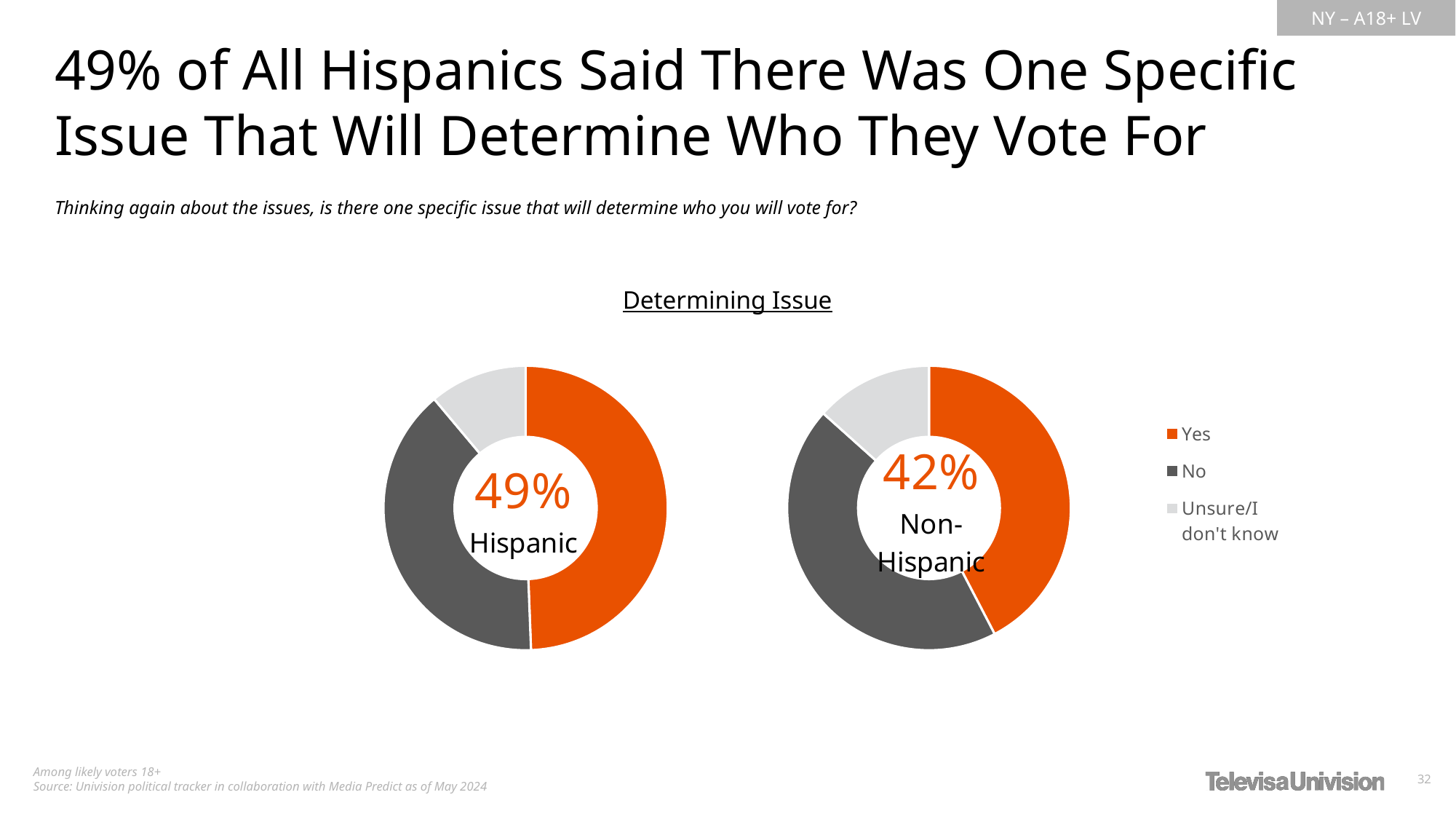
In the Hispanic donut chart, which response is the largest slice? Yes In the Non-Hispanic donut chart, which response is the smallest slice? Unsure/I don't know Which colour represents the Yes response in the donut charts? Orange In the Hispanic donut chart, which response is the smallest slice? Unsure/I don't know In the Non-Hispanic donut chart, what percentage said Yes? 42% How many categories does the legend list for the Determining Issue charts? 3 How many slices does the Hispanic donut chart have? 3 Which group has the higher Yes percentage, Hispanic or Non-Hispanic? Hispanic What kind of chart is used to show the Determining Issue data? Donut (pie) chart What is the difference between the Yes percentage for Hispanics and the Yes percentage for Non-Hispanics? 7 percentage points In the Hispanic donut chart, what percentage said Yes? 49% What is the title shown above the two donut charts? Determining Issue